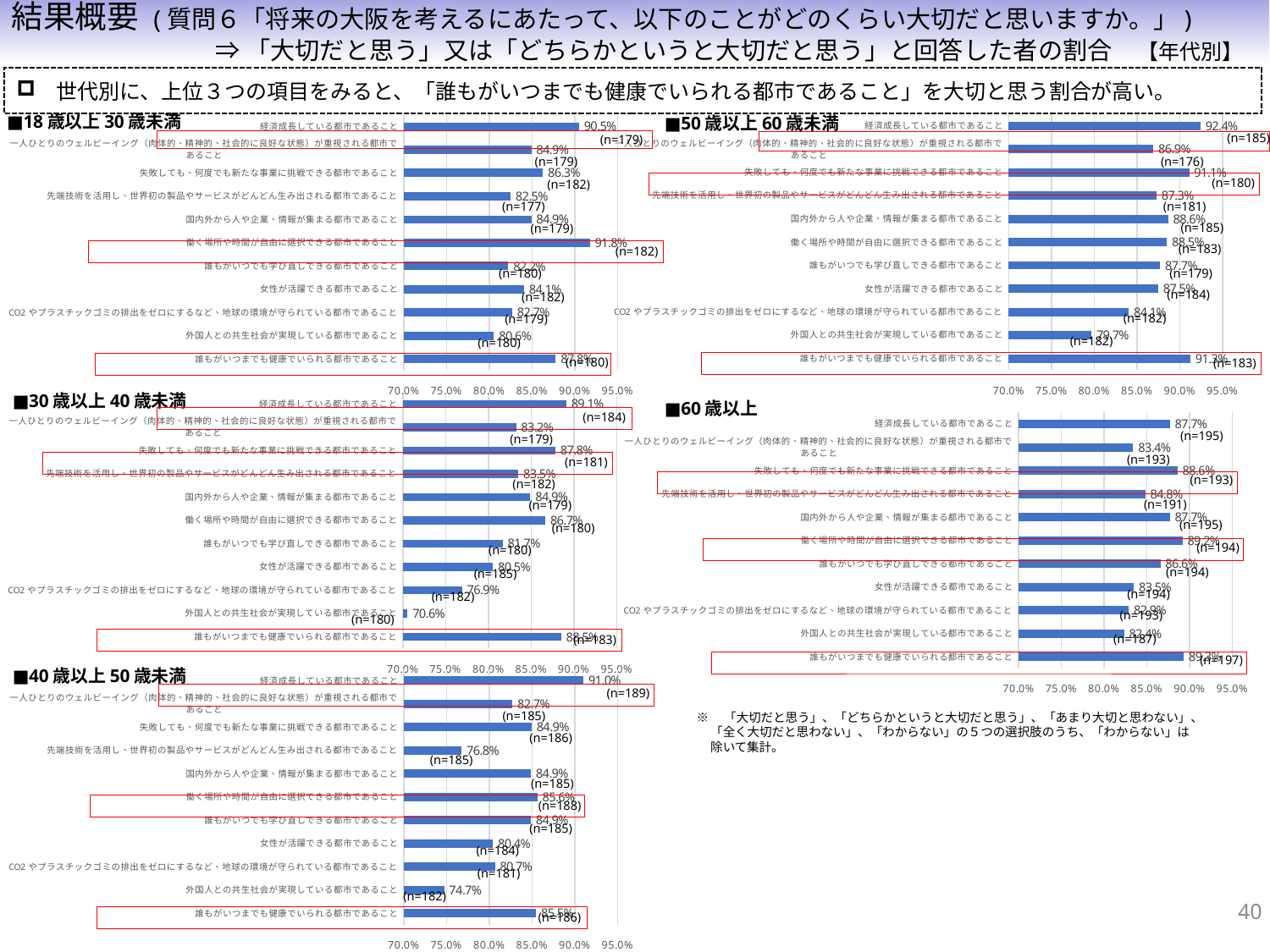
In the ■30歳以上40歳未満 chart, what is the value for 外国人との共生社会が実現している都市であること? 70.6% In the ■60歳以上 chart, which is larger: 失敗しても、何度でも新たな事業に挑戦できる都市であること or 女性が活躍できる都市であること? 失敗しても、何度でも新たな事業に挑戦できる都市であること In the ■30歳以上40歳未満 chart, what is the difference between 経済成長している都市であること and 外国人との共生社会が実現している都市であること? 18.5% In the ■50歳以上60歳未満 chart, is the value for 外国人との共生社会が実現している都市であること greater or less than 80.0%? less In the ■50歳以上60歳未満 chart, which item has the highest value? 経済成長している都市であること What type of chart is used for the ■60歳以上 data? bar chart In the ■18歳以上30歳未満 chart, what is the value for 働く場所や時間が自由に選択できる都市であること? 91.8% How many items are plotted in the ■18歳以上30歳未満 chart? 11 In the ■40歳以上50歳未満 chart, which item has the lowest value? 外国人との共生社会が実現している都市であること In the ■40歳以上50歳未満 chart, what is the value for 先端技術を活用し、世界初の製品やサービスがどんどん生み出される都市であること? 76.8% In the ■60歳以上 chart, what is the value for 働く場所や時間が自由に選択できる都市であること? 89.2% In the ■50歳以上60歳未満 chart, what is the value for 経済成長している都市であること? 92.4%